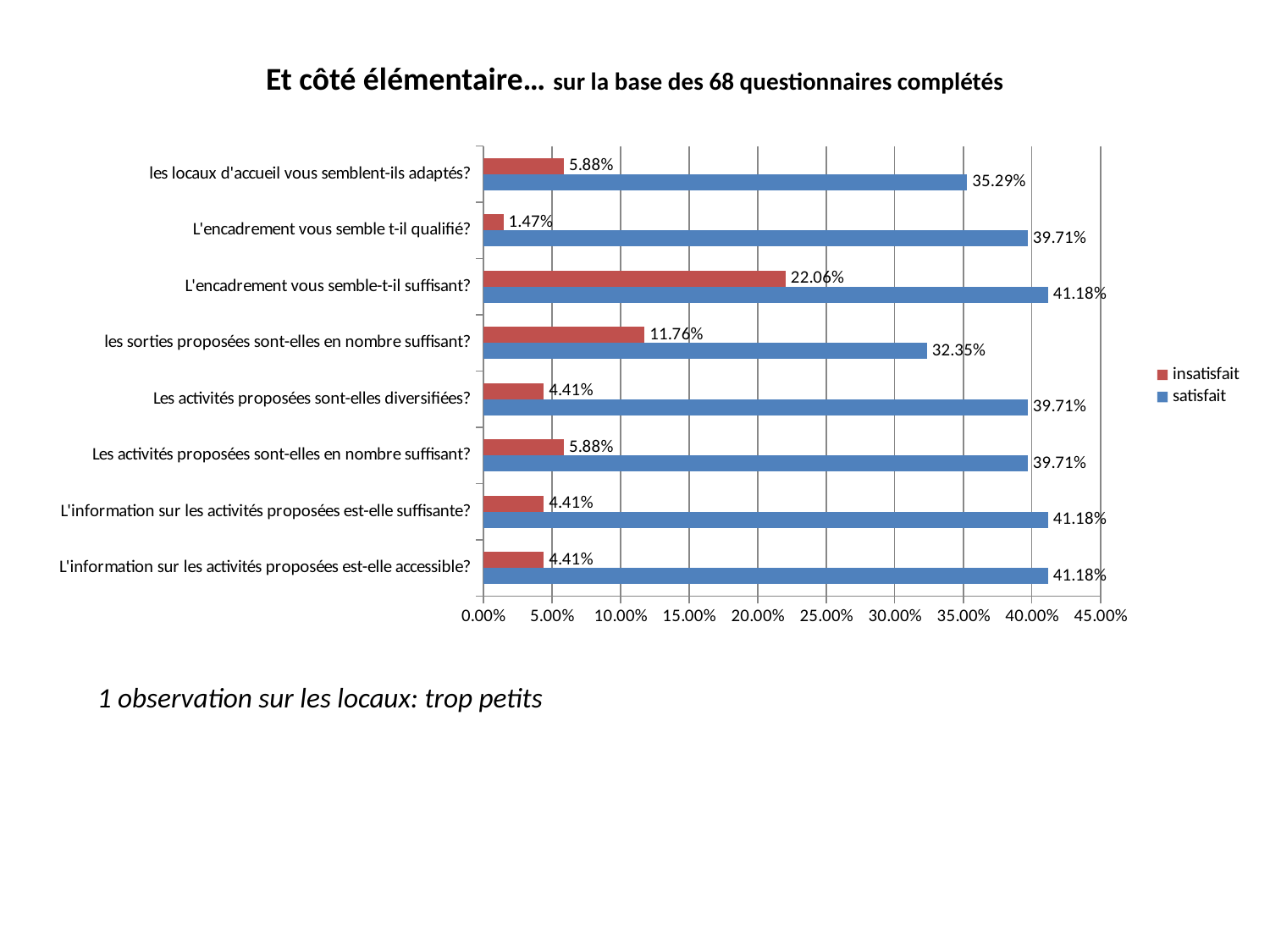
What is the 'insatisfait' value for 'L'encadrement vous semble t-il qualifié?' 1.47% Which legend entry is shown in red? insatisfait What kind of chart is shown on the slide? bar chart What is the 'satisfait' value for 'les locaux d'accueil vous semblent-ils adaptés?' 35.29% Which category has the lowest 'satisfait' value? les sorties proposées sont-elles en nombre suffisant? What is the 'satisfait' value for 'les sorties proposées sont-elles en nombre suffisant?' 32.35% How many categories (questions) are plotted on the chart? 8 What is the 'insatisfait' value for 'L'encadrement vous semble-t-il suffisant?' 22.06% Which category has the highest 'insatisfait' value? L'encadrement vous semble-t-il suffisant? How many series does the legend list? 2 Which is larger: the 'insatisfait' value for 'les locaux d'accueil vous semblent-ils adaptés?' or for 'Les activités proposées sont-elles diversifiées?' les locaux d'accueil vous semblent-ils adaptés? What is the difference between the 'satisfait' and 'insatisfait' values for 'les sorties proposées sont-elles en nombre suffisant?' 20.59%